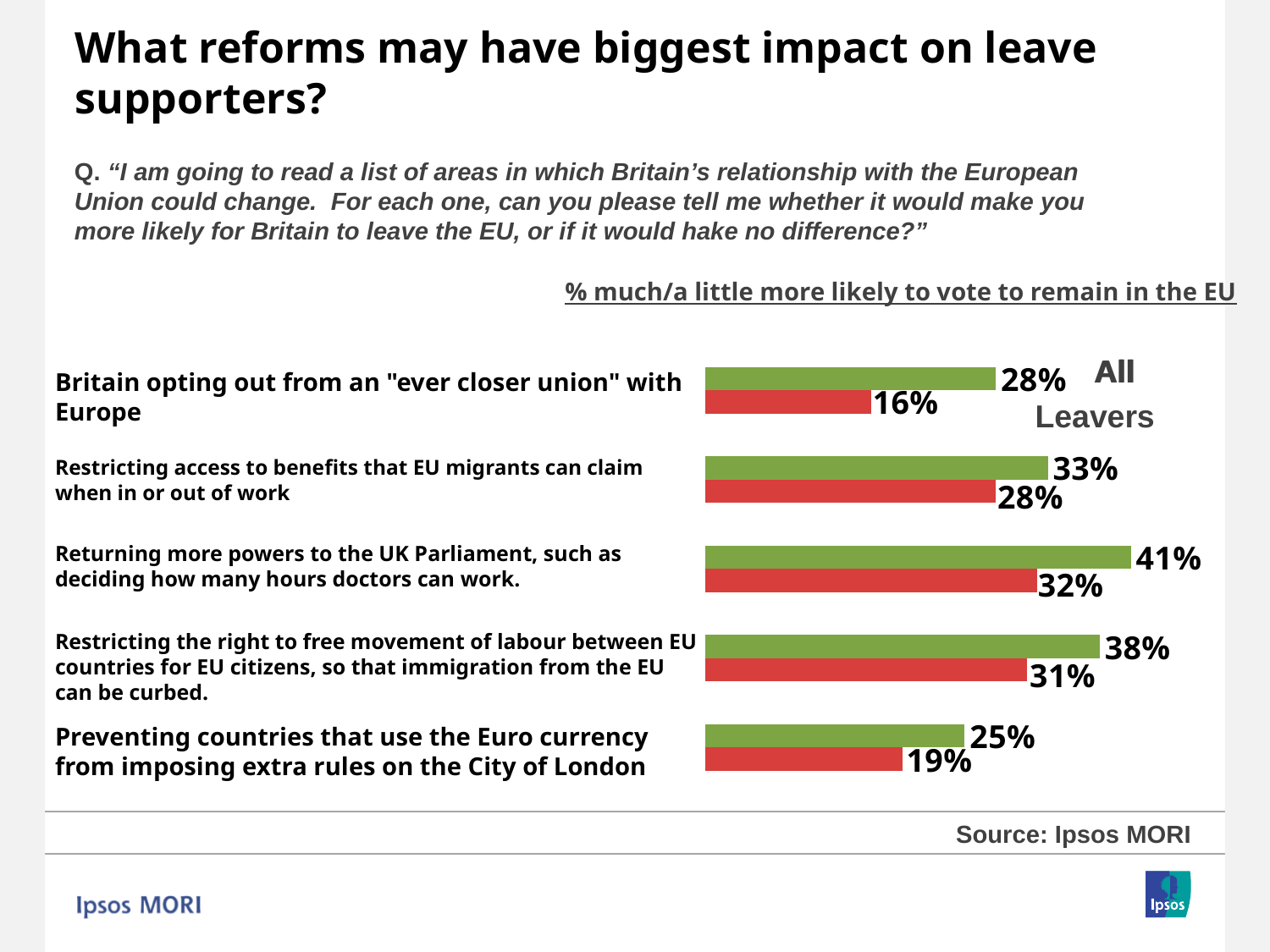
What percentage of Leavers said Britain opting out from an "ever closer union" with Europe would make them more likely to vote to remain? 16% What is the difference between the All and Leavers values for Britain opting out from an "ever closer union" with Europe? 12 percentage points How many series does the chart show? 2 What percentage of all respondents said returning more powers to the UK Parliament would make them more likely to vote to remain in the EU? 41% What is the difference between the All values for returning more powers to the UK Parliament and preventing Euro countries from imposing extra rules on the City of London? 16 percentage points Which reform has the highest value among all respondents? Returning more powers to the UK Parliament, such as deciding how many hours doctors can work. What type of chart is shown on the slide? Bar chart Which reform has the lowest value among Leavers? Britain opting out from an "ever closer union" with Europe Among Leavers, which is larger: the value for restricting access to benefits that EU migrants can claim, or the value for preventing Euro countries from imposing extra rules on the City of London? Restricting access to benefits that EU migrants can claim How many reforms are listed in the chart? 5 Which colour represents the Leavers series in the chart? Red What is the Leavers value for restricting the right to free movement of labour between EU countries? 31%